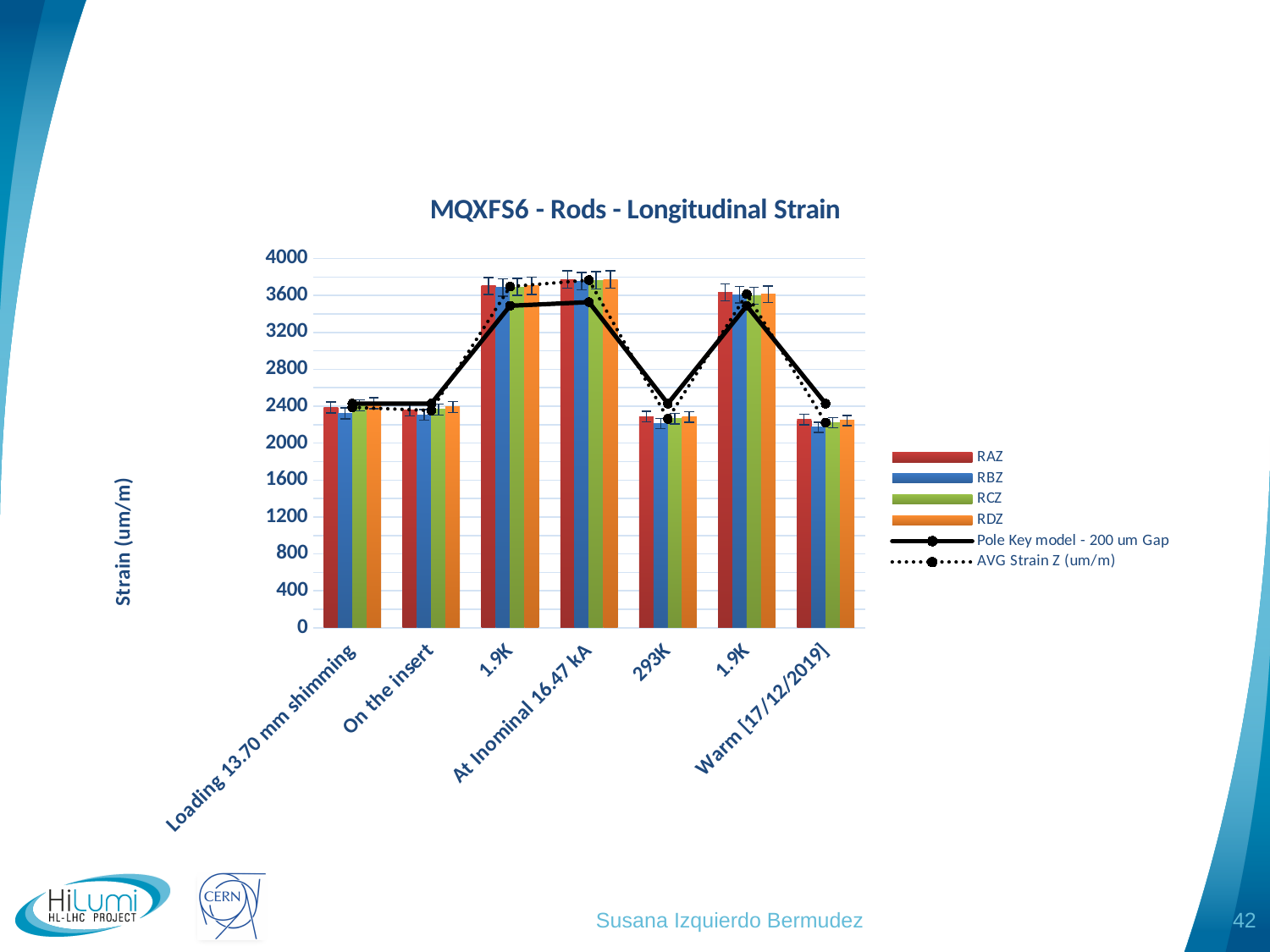
Is the RAZ value for 'On the insert' greater or less than 2800? less How many categories are shown along the x axis of the chart? 7 How many series does the chart's legend list? 6 What is the title of the chart? MQXFS6 - Rods - Longitudinal Strain What is the label of the vertical axis? Strain (um/m) Do the bar values rise or fall from 'At Inominal 16.47 kA' to '293K'? fall Is the RDZ value for the first '1.9K' category greater or less than 3200? greater Is the RBZ value for '293K' greater or less than 2400? less Which is larger, the RAZ value for 'At Inominal 16.47 kA' or the RAZ value for '293K'? At Inominal 16.47 kA What kind of chart is shown on the slide? combination bar and line chart